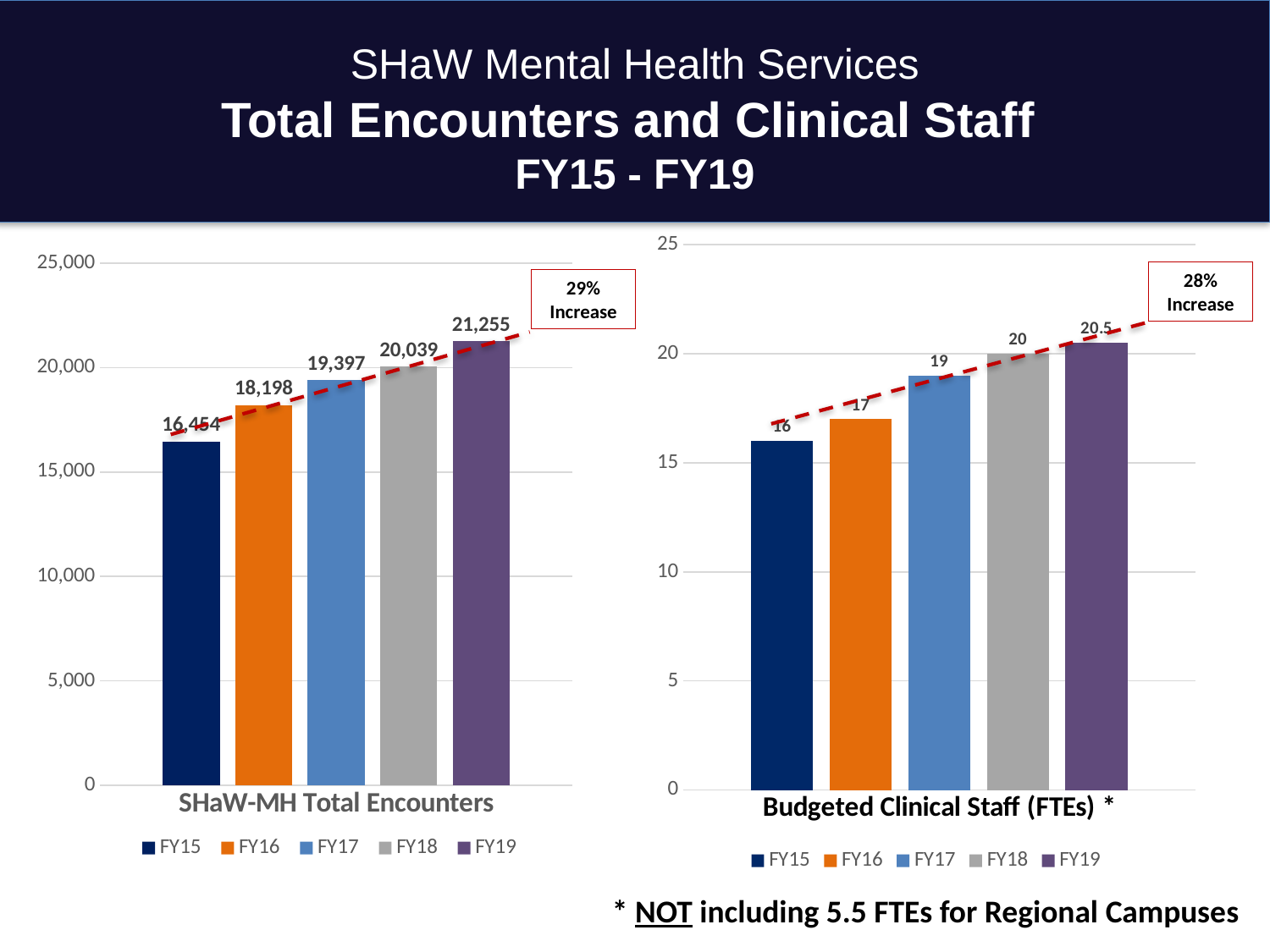
In the SHaW-MH Total Encounters chart, is the value for FY16 greater or less than 20,000? less In the Budgeted Clinical Staff (FTEs) chart, which fiscal year has the lowest value? FY15 In the SHaW-MH Total Encounters chart, what is the value for FY17? 19,397 In the Budgeted Clinical Staff (FTEs) chart, what is the value for FY19? 20.5 In the Budgeted Clinical Staff (FTEs) chart, what is the difference between the FY19 and FY15 values? 4.5 In the SHaW-MH Total Encounters chart, what is the value for FY19? 21,255 In the Budgeted Clinical Staff (FTEs) chart, do the values rise or fall from FY15 to FY19? rise In the SHaW-MH Total Encounters chart, what is the difference between the FY19 and FY18 values? 1,216 In the Budgeted Clinical Staff (FTEs) chart, what is the value for FY16? 17 What kind of chart is the SHaW-MH Total Encounters chart? bar chart How many series does the legend of the Budgeted Clinical Staff (FTEs) chart list? 5 In the SHaW-MH Total Encounters chart, which fiscal year has the highest value? FY19